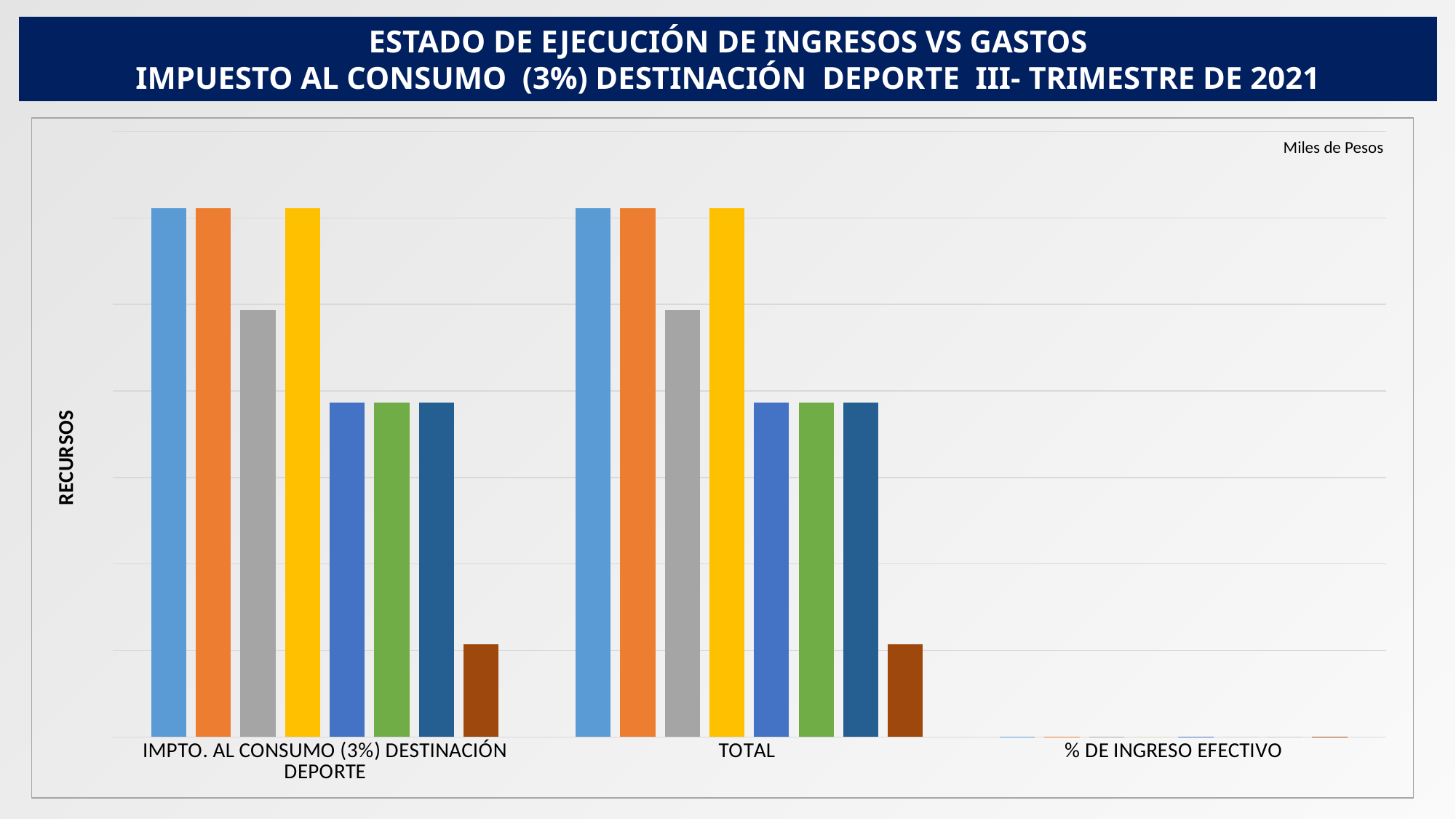
Are the bars for TOTAL taller or shorter than the bars for % DE INGRESO EFECTIVO? taller What is the label on the vertical axis of the chart? RECURSOS Which category on the x axis has the smallest bars? % DE INGRESO EFECTIVO How many bars are plotted for the TOTAL category? 8 What kind of chart is shown on the slide? bar chart What unit note is printed in the top right corner of the chart area? Miles de Pesos How many categories are shown on the x axis of the chart? 3